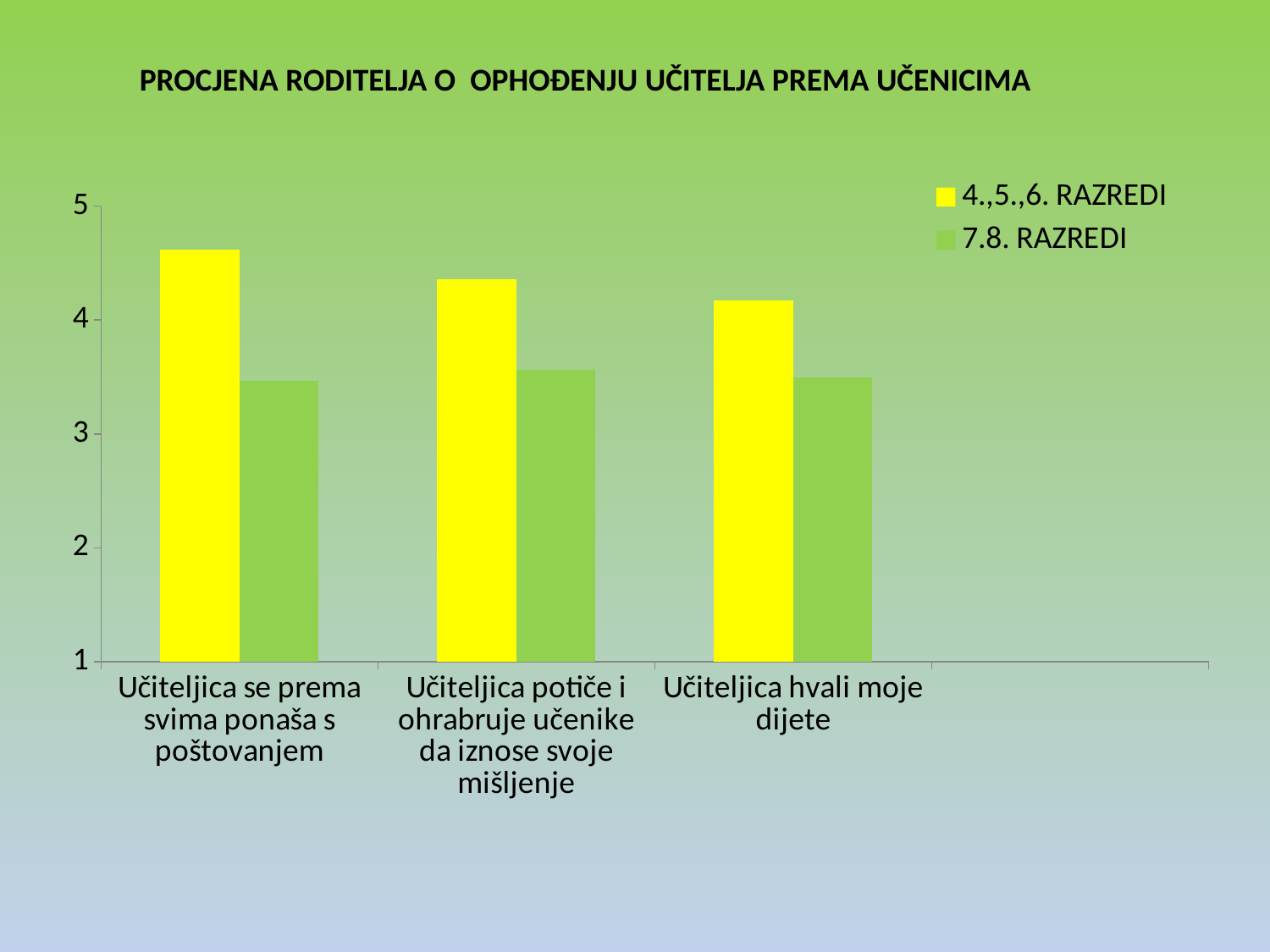
How many series does the legend list? 2 Is the value for 7.8. RAZREDI for 'Učiteljica potiče i ohrabruje učenike da iznose svoje mišljenje' greater or less than 4? less Do the values for 4.,5.,6. RAZREDI rise or fall from left to right across the categories? fall For 'Učiteljica se prema svima ponaša s poštovanjem', which series has the larger value, 4.,5.,6. RAZREDI or 7.8. RAZREDI? 4.,5.,6. RAZREDI Is the value for 4.,5.,6. RAZREDI for 'Učiteljica se prema svima ponaša s poštovanjem' greater or less than 4? greater What is the title of the chart? PROCJENA RODITELJA O OPHOĐENJU UČITELJA PREMA UČENICIMA What kind of chart is shown on the slide? bar chart For which category is the value for 4.,5.,6. RAZREDI highest? Učiteljica se prema svima ponaša s poštovanjem How many categories are shown on the x axis? 3 For 'Učiteljica hvali moje dijete', which series has the larger value, 4.,5.,6. RAZREDI or 7.8. RAZREDI? 4.,5.,6. RAZREDI Which series is shown in yellow? 4.,5.,6. RAZREDI For which category is the value for 4.,5.,6. RAZREDI lowest? Učiteljica hvali moje dijete